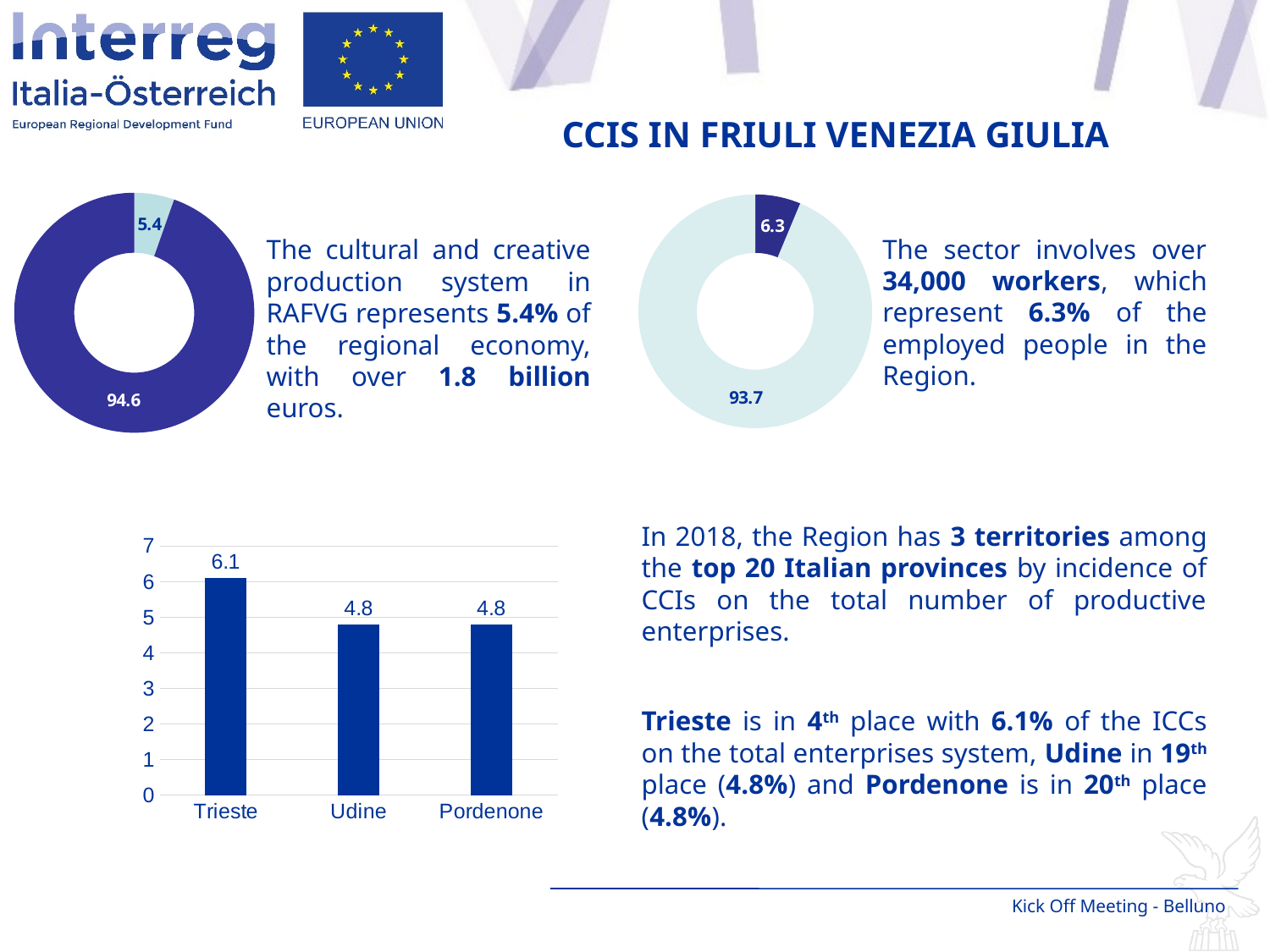
In the bar chart at the bottom left, what is the value for Pordenone? 4.8 In the bar chart at the bottom left, what is the value for Trieste? 6.1 What kind of chart is shown at the bottom left of the slide? bar chart In the bar chart at the bottom left, which category has the highest value? Trieste In the bar chart at the bottom left, what is the difference between the values for Trieste and Udine? 1.3 In the bar chart at the bottom left, is the value for Trieste larger or smaller than the value for Pordenone? larger In the donut chart at the top left, what value is shown on the smaller slice? 5.4 How many categories are shown in the bar chart at the bottom left? 3 In the donut chart at the top left, what value is shown on the larger slice? 94.6 In the bar chart at the bottom left, what is the value for Udine? 4.8 In the bar chart at the bottom left, is the value for Udine greater or less than 5? less In the donut chart at the top right, what value is shown on the larger slice? 93.7